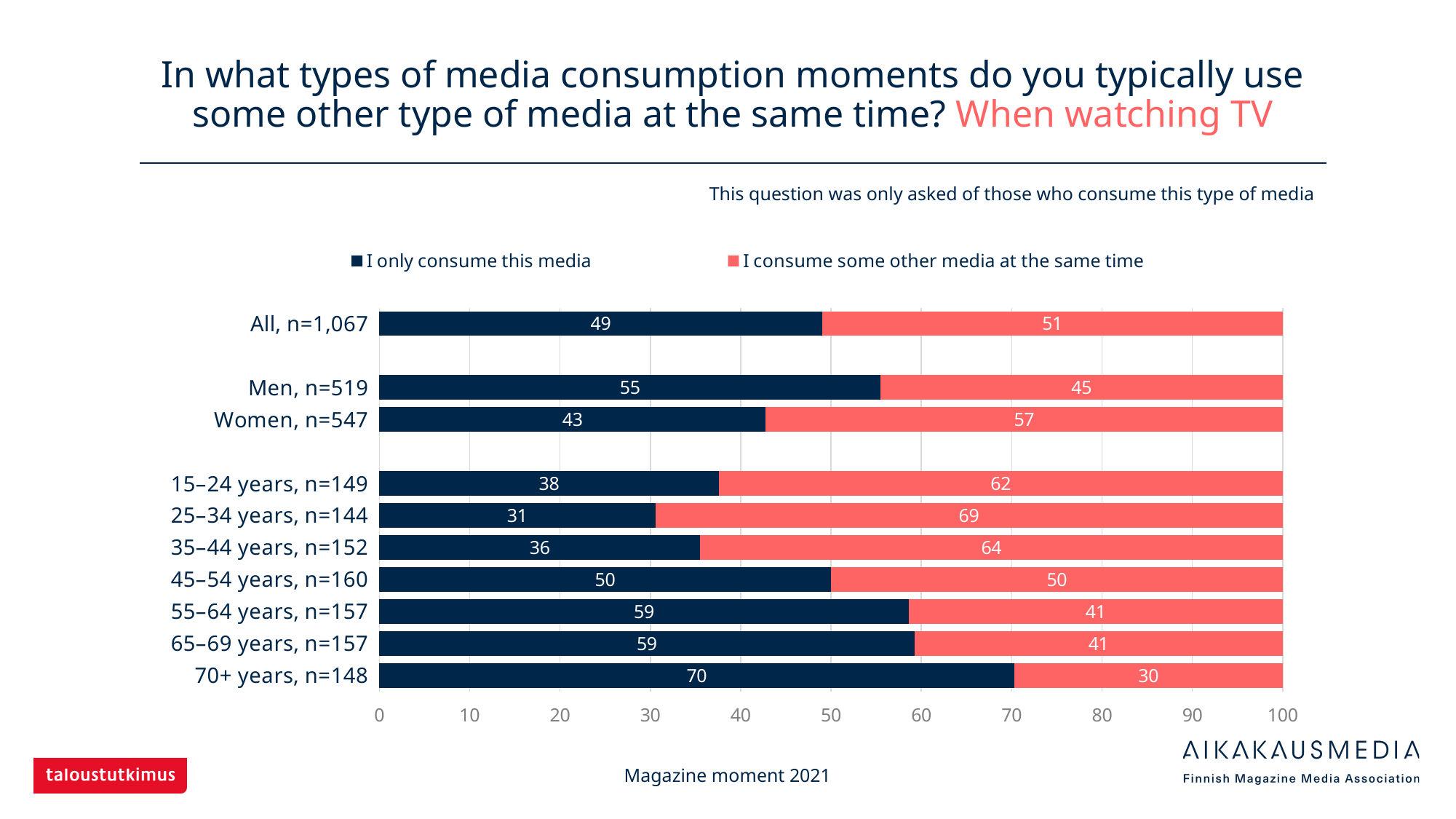
What kind of chart is shown on the slide? Stacked bar chart Which category has the lowest value for "I only consume this media"? 25–34 years, n=144 What is the value of "I consume some other media at the same time" for 25–34 years, n=144? 69 Which is larger: the "I only consume this media" value for 15–24 years, n=149 or for 35–44 years, n=152? 15–24 years, n=149 Which category has the highest value for "I only consume this media"? 70+ years, n=148 What is the value of "I only consume this media" for All, n=1,067? 49 How many series does the legend list? 2 How many categories are shown on the chart? 10 What is the value of "I only consume this media" for Men, n=519? 55 What colour represents "I consume some other media at the same time" in the chart? Red (coral) What is the total of the stacked bar for 45–54 years, n=160? 100 What is the difference between the "I consume some other media at the same time" values for Women, n=547 and Men, n=519? 12